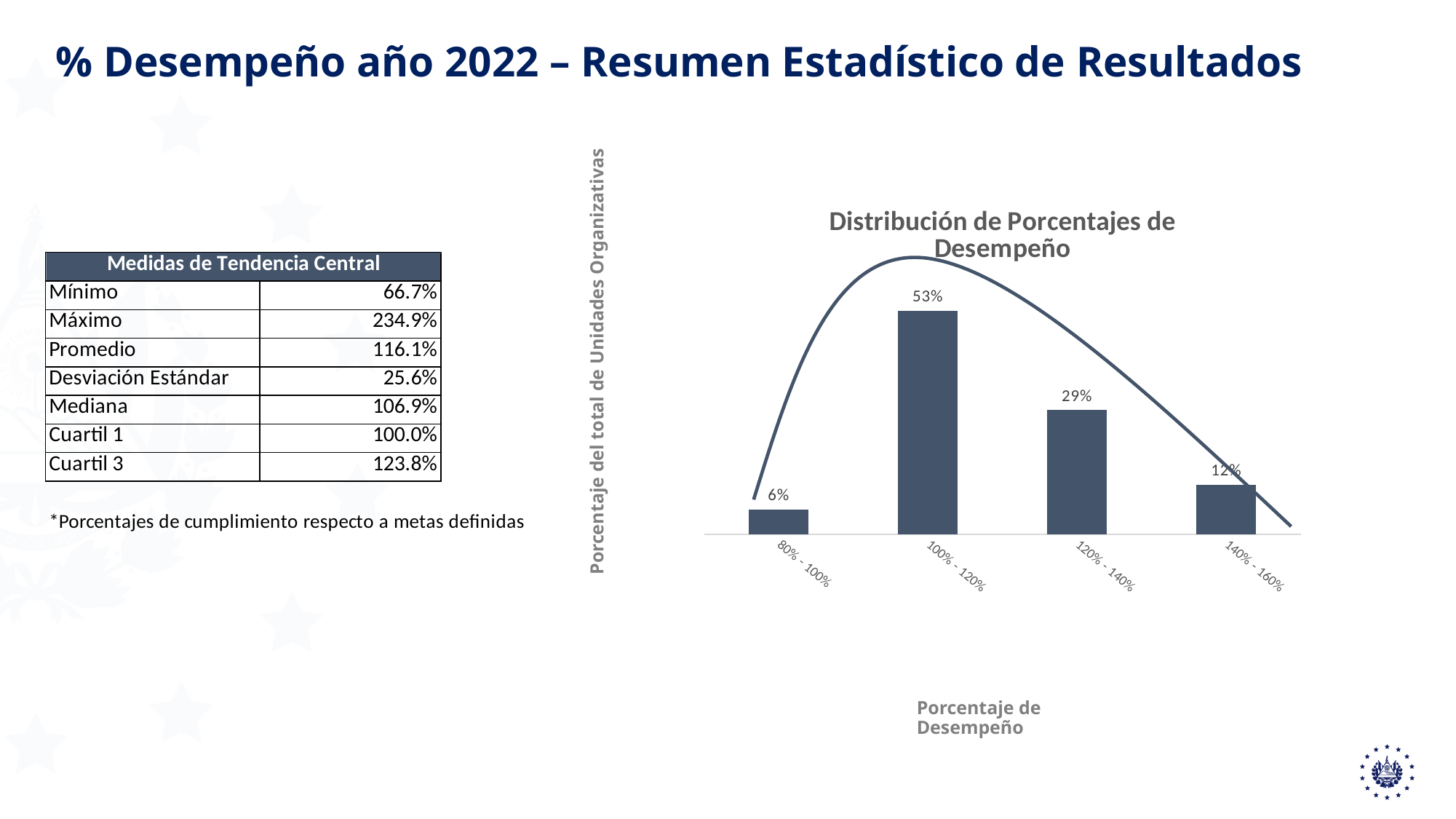
How many categories are shown on the x axis of the chart? 4 What is the value for the 80% - 100% category in the chart? 6% What is the difference between the values for 100% - 120% and 120% - 140%? 24% Which category has the lowest value in the chart? 80% - 100% Which category has the highest value in the chart? 100% - 120% What is the value for the 100% - 120% category in the Distribución de Porcentajes de Desempeño chart? 53% What is the label of the y axis of the chart? Porcentaje del total de Unidades Organizativas What is the value for the 120% - 140% category in the chart? 29% What kind of chart is shown on the slide? Bar chart Which is larger, the value for 120% - 140% or the value for 140% - 160%? 120% - 140% What is the value for the 140% - 160% category in the chart? 12% What is the title of the chart? Distribución de Porcentajes de Desempeño